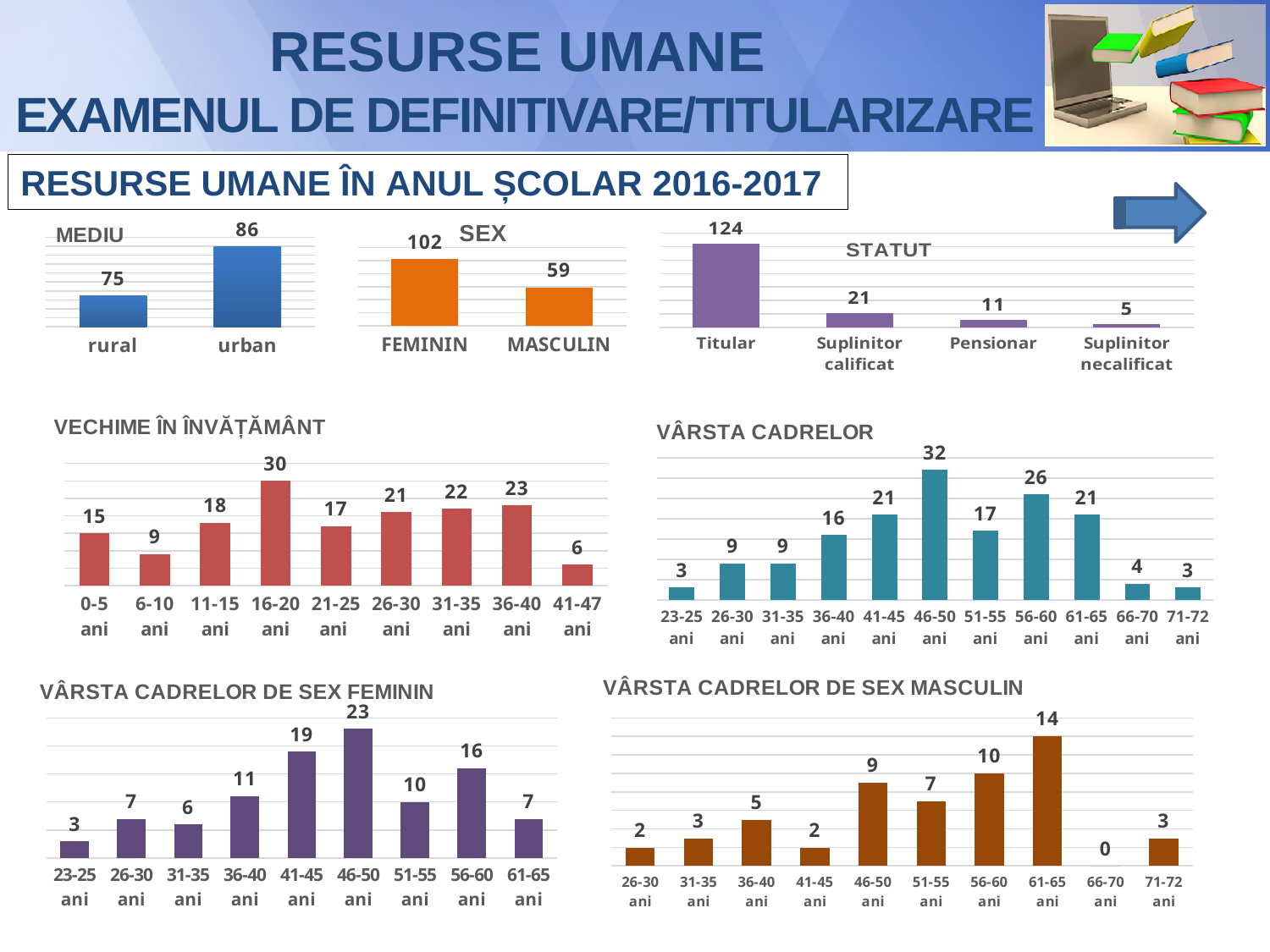
In the VÂRSTA CADRELOR DE SEX FEMININ chart, which is larger, 41-45 ani or 56-60 ani? 41-45 ani In the SEX chart, what is the difference between FEMININ and MASCULIN? 43 In the VÂRSTA CADRELOR chart, what is the value for 46-50 ani? 32 In the VECHIME ÎN ÎNVĂȚĂMÂNT chart, how many categories are shown? 9 What type of chart is the VÂRSTA CADRELOR DE SEX FEMININ chart? bar chart In the STATUT chart, what is the value for Pensionar? 11 In the VECHIME ÎN ÎNVĂȚĂMÂNT chart, which category has the highest value? 16-20 ani In the VÂRSTA CADRELOR chart, which category has the lowest value? 23-25 ani and 71-72 ani (both 3) In the VÂRSTA CADRELOR DE SEX MASCULIN chart, what is the value for 66-70 ani? 0 In the STATUT chart, which category has the highest value? Titular In the MEDIU chart, what is the value for urban? 86 In the VÂRSTA CADRELOR DE SEX MASCULIN chart, how many categories are shown? 10